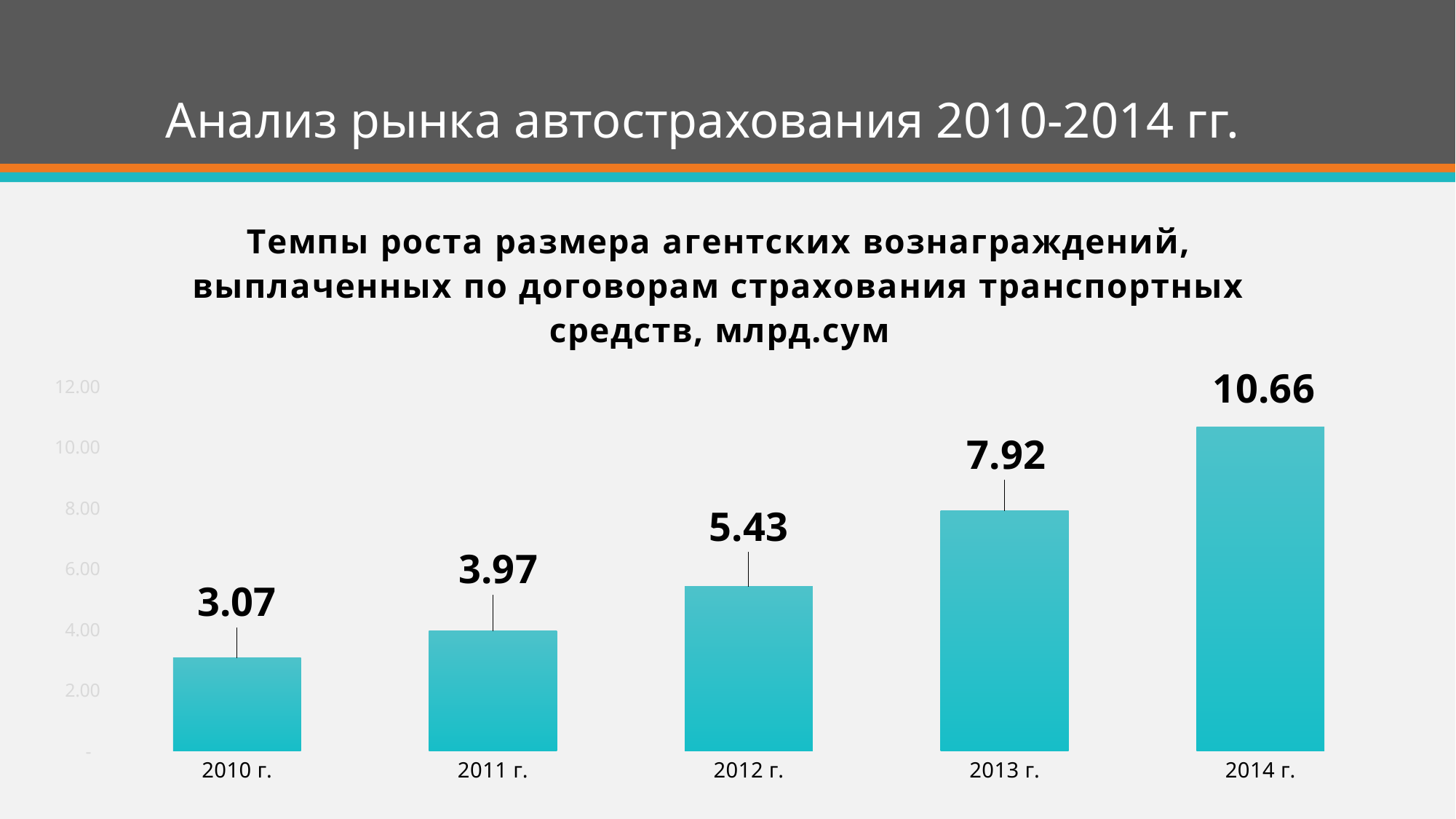
How many years are shown on the chart? 5 Which is larger, the value for 2012 г. or the value for 2013 г.? 2013 г. What is the value for 2012 г.? 5.43 Do the values rise or fall from 2010 г. to 2014 г.? rise What is the value for 2010 г.? 3.07 Which year has the lowest value? 2010 г. What is the difference between the values for 2014 г. and 2013 г.? 2.74 Which year has the highest value? 2014 г. What kind of chart is shown on the slide? bar chart What is the difference between the values for 2011 г. and 2010 г.? 0.90 Is the value for 2013 г. greater or less than 8.00? less What is the value for 2014 г.? 10.66